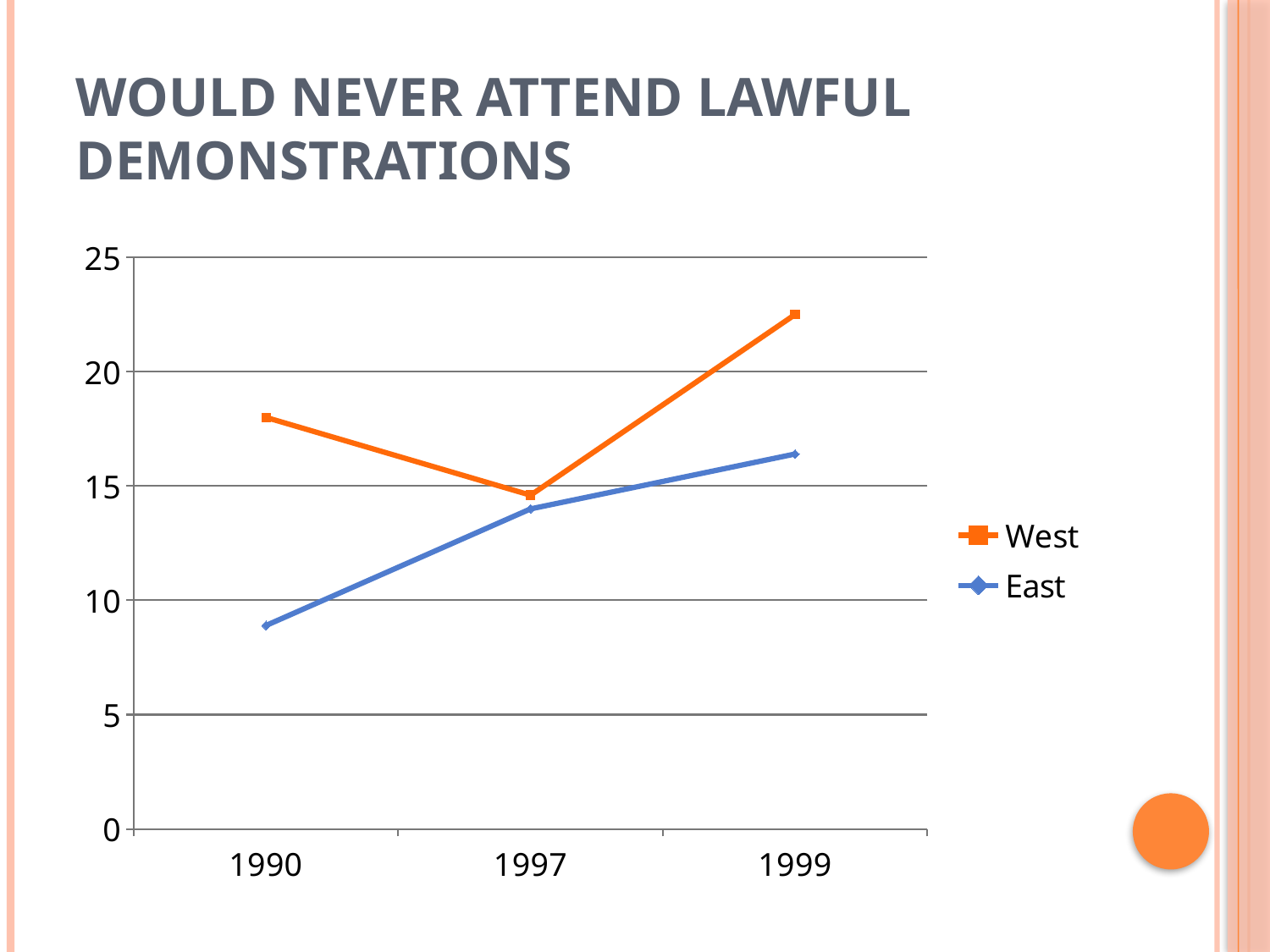
How many series does the legend list? 2 Does the East series rise or fall from 1990 to 1999? rise In which year is the West series at its lowest? 1997 Is the value for East in 1990 greater or less than 10? less In which year is the East series at its lowest? 1990 Is the value for West in 1999 greater or less than 20? greater In which year is the West series at its highest? 1999 What kind of chart is shown on the slide? line chart In 1999, which series has the larger value, West or East? West How many years are plotted along the x axis? 3 What is the title of the chart? Would Never Attend Lawful Demonstrations In 1990, which series has the larger value, West or East? West